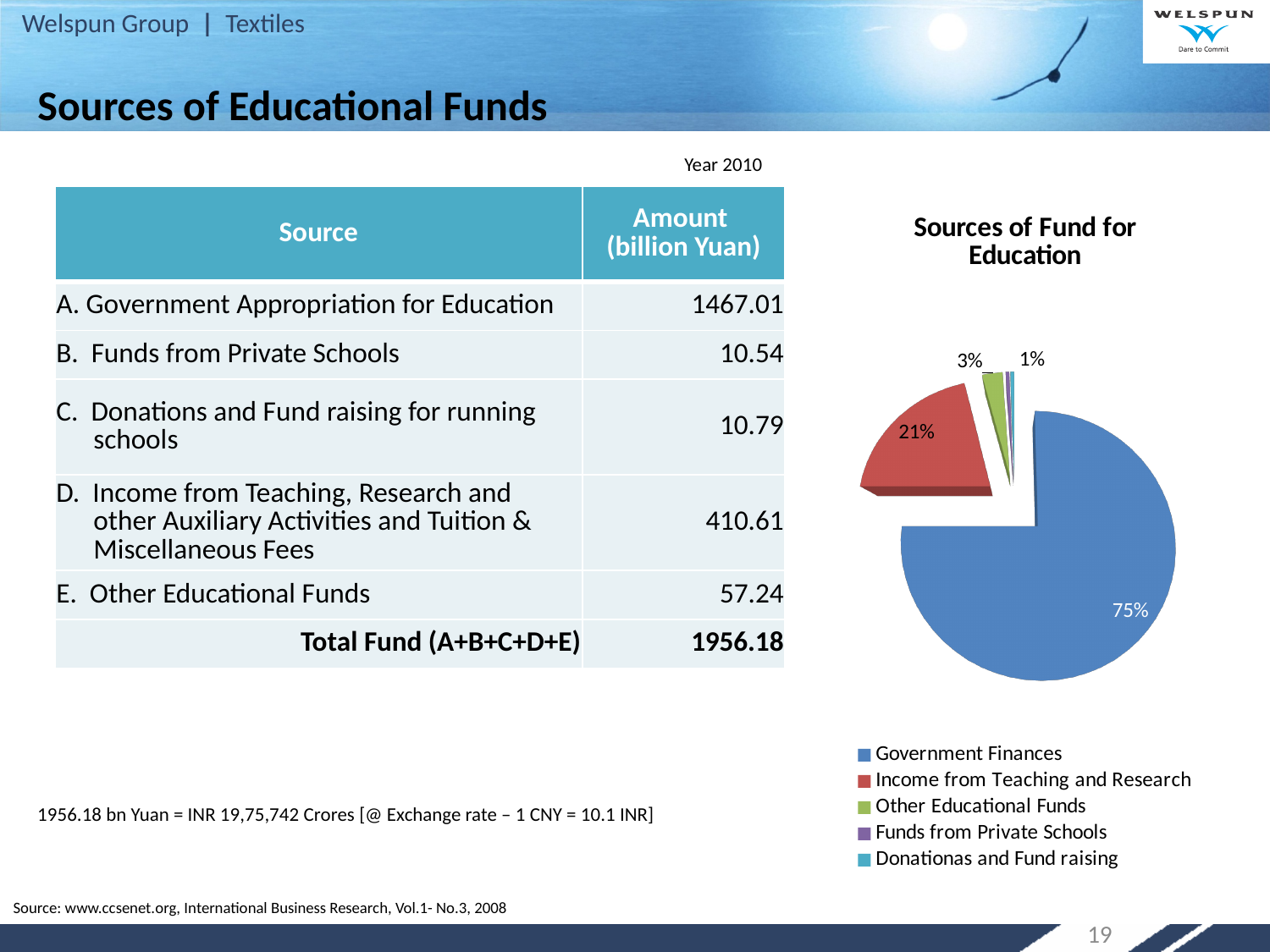
Which is larger: the share for Income from Teaching and Research or the share for Other Educational Funds? Income from Teaching and Research Which category has the largest slice of the pie? Government Finances What colour is the Government Finances slice in the pie chart? blue What is the title of the chart on the slide? Sources of Fund for Education How many categories does the chart's legend list? 5 What share of the pie does Income from Teaching and Research represent? 21% Is the share for Income from Teaching and Research greater or less than 50%? less What share of the pie does Other Educational Funds represent? 3% By how many percentage points does the Government Finances share exceed the Income from Teaching and Research share? 54 percentage points What share of the pie does Government Finances represent? 75% What kind of chart is shown on the slide? pie chart Which is larger: the share for Government Finances or the share for Income from Teaching and Research? Government Finances